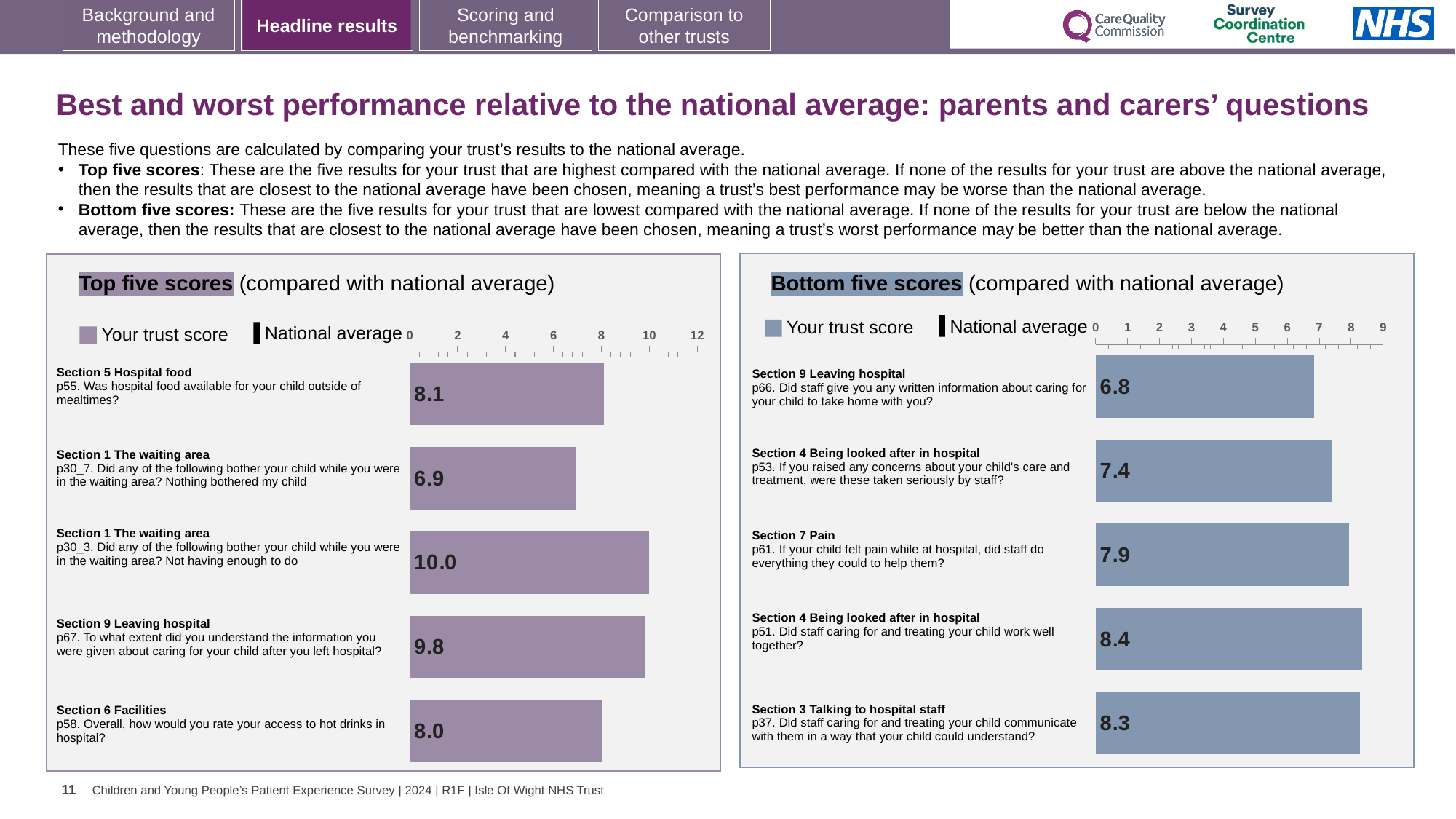
In the Top five scores chart, which question has the highest trust score? p30_3. Did any of the following bother your child while you were in the waiting area? Not having enough to do What type of chart is the Bottom five scores chart? Bar chart What are the two legend entries shown for the Top five scores chart? Your trust score; National average In the Top five scores chart, which question has the lowest trust score? p30_7. Did any of the following bother your child while you were in the waiting area? Nothing bothered my child In the Top five scores chart, what is the trust score for p55 (Was hospital food available for your child outside of mealtimes)? 8.1 How many questions are plotted in the Top five scores chart? 5 In the Bottom five scores chart, which question has the lowest trust score? p66. Did staff give you any written information about caring for your child to take home with you? In the Bottom five scores chart, which question has the highest trust score? p51. Did staff caring for and treating your child work well together? In the Top five scores chart, what is the difference between the trust scores for p30_3 and p58? 2.0 In the Bottom five scores chart, what is the difference between the trust scores for p51 and p66? 1.6 In the Bottom five scores chart, what is the trust score for p61 (If your child felt pain while at hospital, did staff do everything they could to help them)? 7.9 In the Bottom five scores chart, which has the larger trust score: p53 or p37? p37